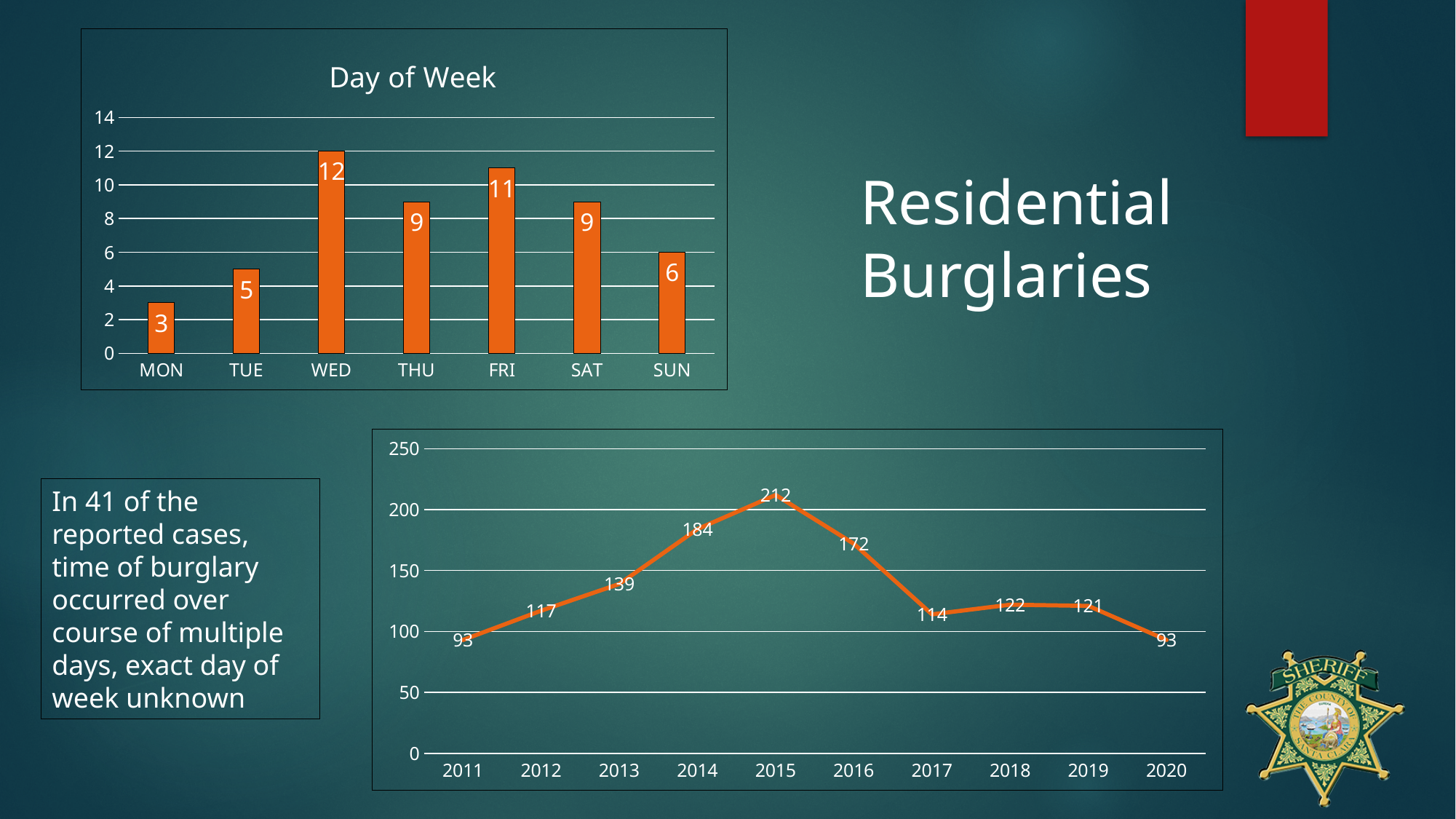
In the 'Day of Week' chart, which day has the lowest value? MON In the line chart at the bottom of the slide, which year has the highest value? 2015 In the line chart at the bottom of the slide, how many years are plotted? 10 In the line chart at the bottom of the slide, what is the difference between the values for 2014 and 2013? 45 In the 'Day of Week' chart, what is the value for WED? 12 In the 'Day of Week' chart, which day has the highest value? WED What kind of chart is the 'Day of Week' chart? bar chart In the 'Day of Week' chart, how many days are shown on the x axis? 7 In the 'Day of Week' chart, what is the difference between the values for FRI and SUN? 5 In the line chart at the bottom of the slide, do the values rise or fall from 2015 to 2017? fall In the line chart at the bottom of the slide, which is larger, the value for 2016 or the value for 2017? 2016 In the line chart at the bottom of the slide, what is the value for 2015? 212